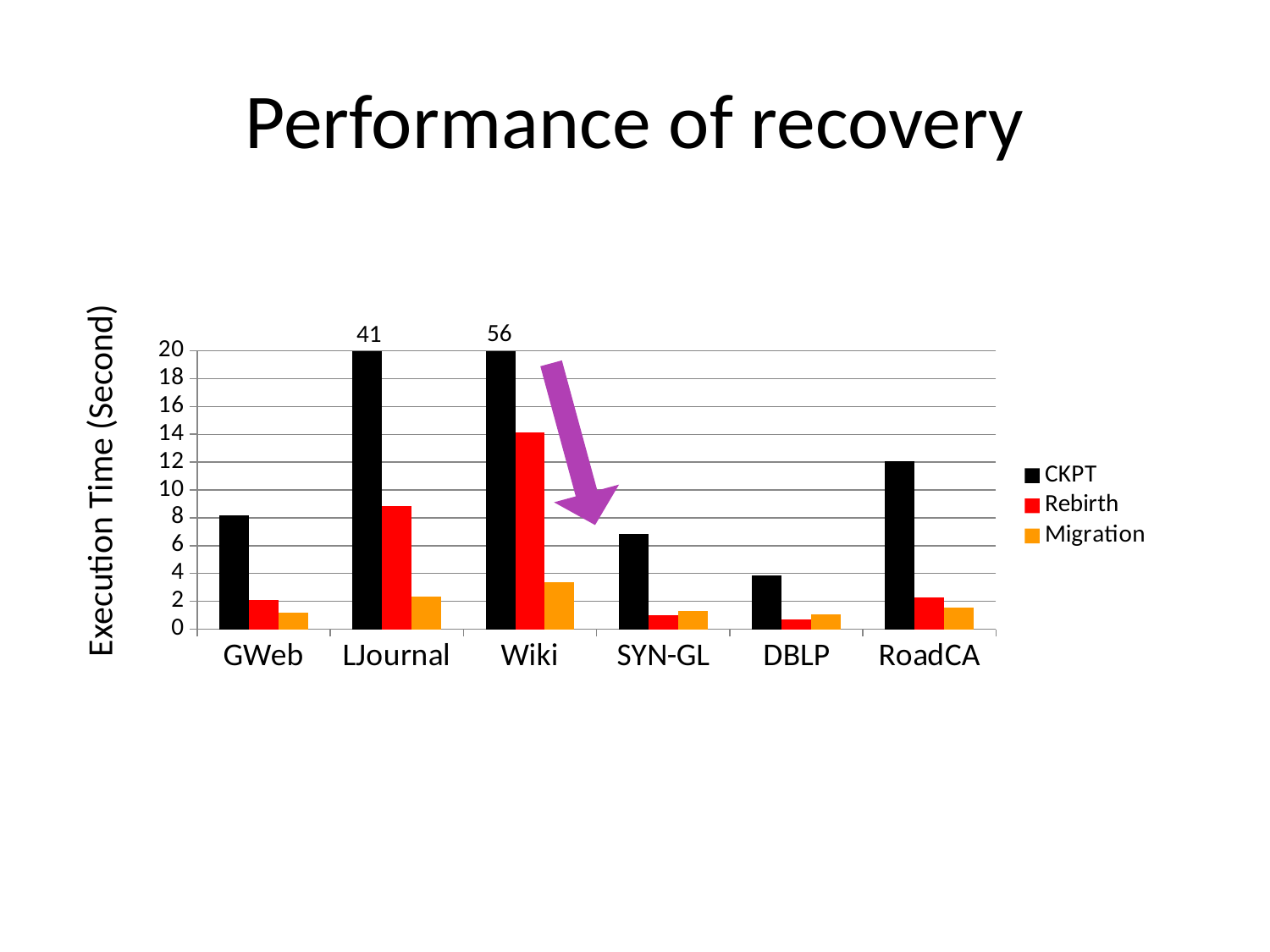
Which category has the lowest CKPT value? DBLP Which category has the highest CKPT value? Wiki What is the CKPT value for Wiki? 56 What is the difference between the CKPT values for Wiki and LJournal? 15 What is the label of the y axis? Execution Time (Second) Which is larger, the CKPT value for Wiki or for LJournal? Wiki How many categories are shown on the x axis of the chart? 6 Is the CKPT value for GWeb greater or less than 10? less What is the CKPT value for LJournal? 41 How many series does the legend list? 3 Is the Rebirth value for Wiki greater or less than 12? greater What kind of chart is shown on the slide? bar chart